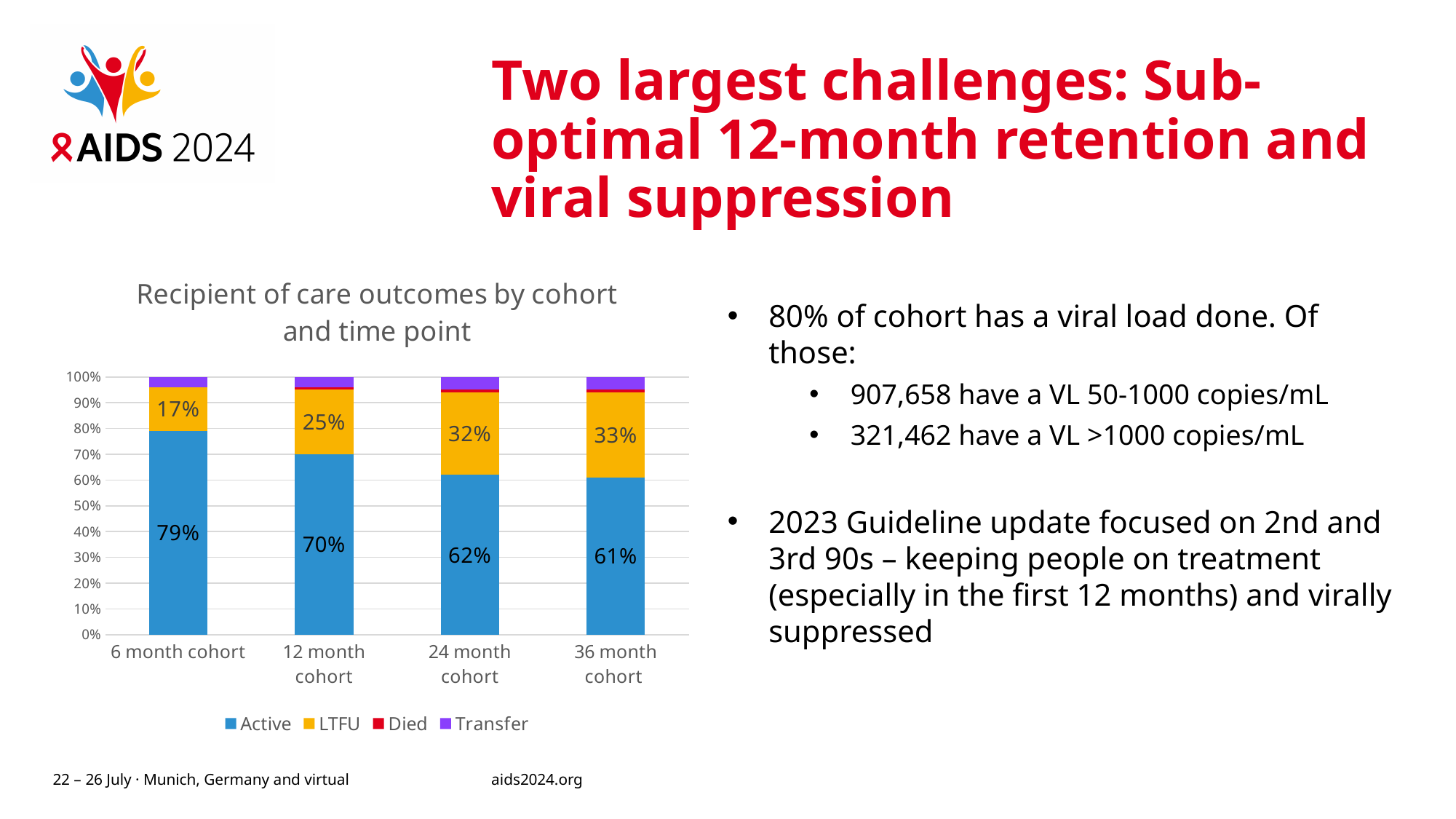
How many cohorts are shown on the x axis? 4 Which cohort has the highest Active share? 6 month cohort What is the LTFU share for the 12 month cohort? 25% Does the Active share rise or fall from the 6 month cohort to the 36 month cohort? Fall What is the Active share for the 6 month cohort? 79% What is the difference in Active share between the 6 month cohort and the 12 month cohort? 9% What is the Active share for the 36 month cohort? 61% What kind of chart is shown? Stacked bar chart Which is larger, the LTFU share for the 24 month cohort or the 36 month cohort? 36 month cohort What is the LTFU share for the 24 month cohort? 32% Which cohort has the lowest LTFU share? 6 month cohort How many series does the legend list? 4